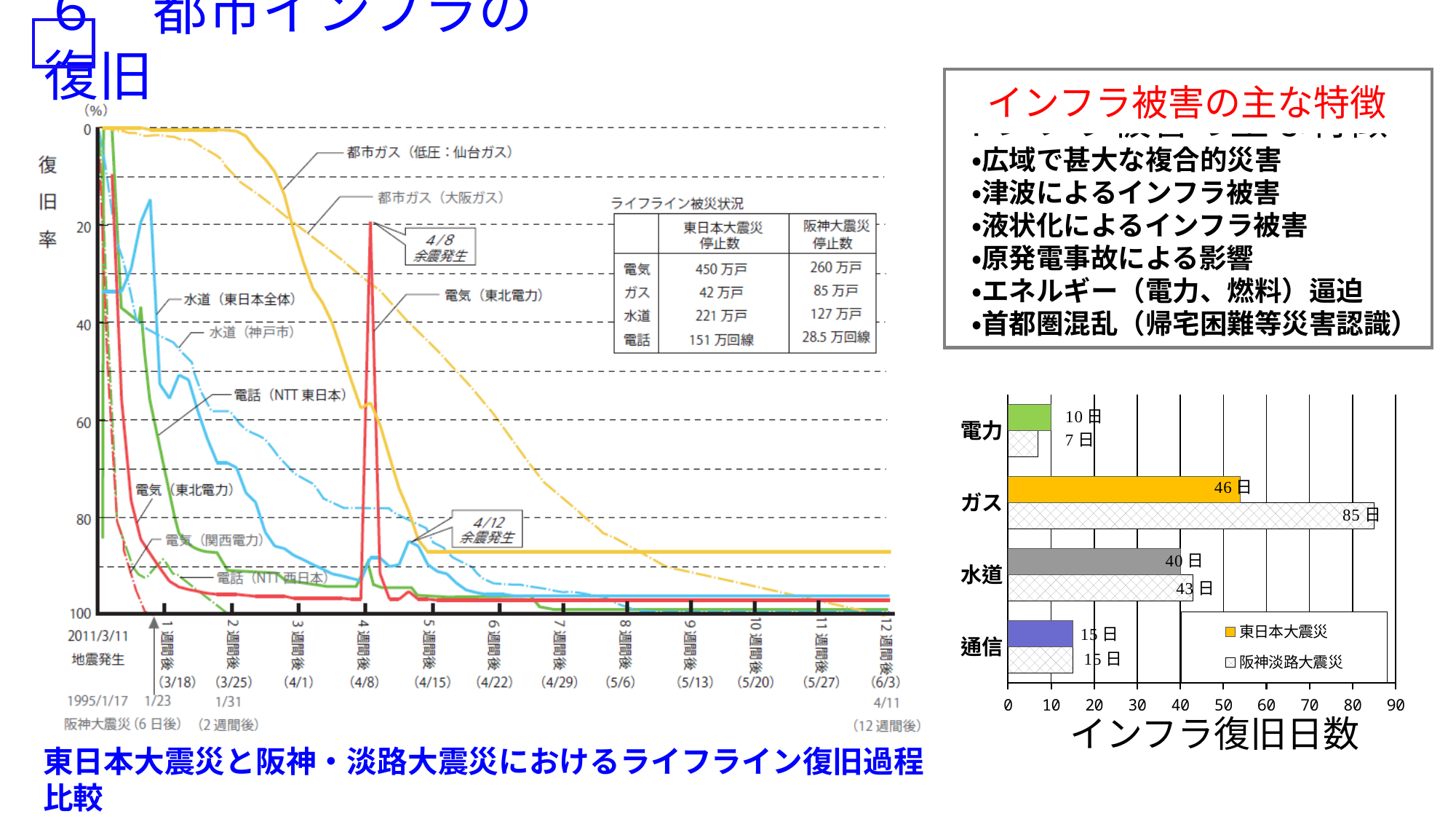
In the bar chart titled インフラ復旧日数, what is the difference between the 阪神淡路大震災 and 東日本大震災 values for ガス? 39 日 In the bar chart titled インフラ復旧日数, what is the value for ガス in the 阪神淡路大震災 series? 85 日 In the bar chart titled インフラ復旧日数, what is the value for 通信 in the 阪神淡路大震災 series? 15 日 In the bar chart titled インフラ復旧日数, which category has the lowest value in the 阪神淡路大震災 series? 電力 In the bar chart titled インフラ復旧日数, which category has the highest value in the 阪神淡路大震災 series? ガス In the bar chart titled インフラ復旧日数, how many series does the legend list? 2 In the bar chart titled インフラ復旧日数, how many categories are shown on the vertical axis? 4 In the bar chart titled インフラ復旧日数, which is larger for 水道: the 東日本大震災 value or the 阪神淡路大震災 value? 阪神淡路大震災 In the bar chart titled インフラ復旧日数, what is the value for 電力 in the 東日本大震災 series? 10 日 In the bar chart titled インフラ復旧日数, what is the highest value shown on the horizontal axis? 90 What kind of chart is the chart titled インフラ復旧日数 on the right of the slide? bar chart In the bar chart titled インフラ復旧日数, what is the value for 水道 in the 東日本大震災 series? 40 日